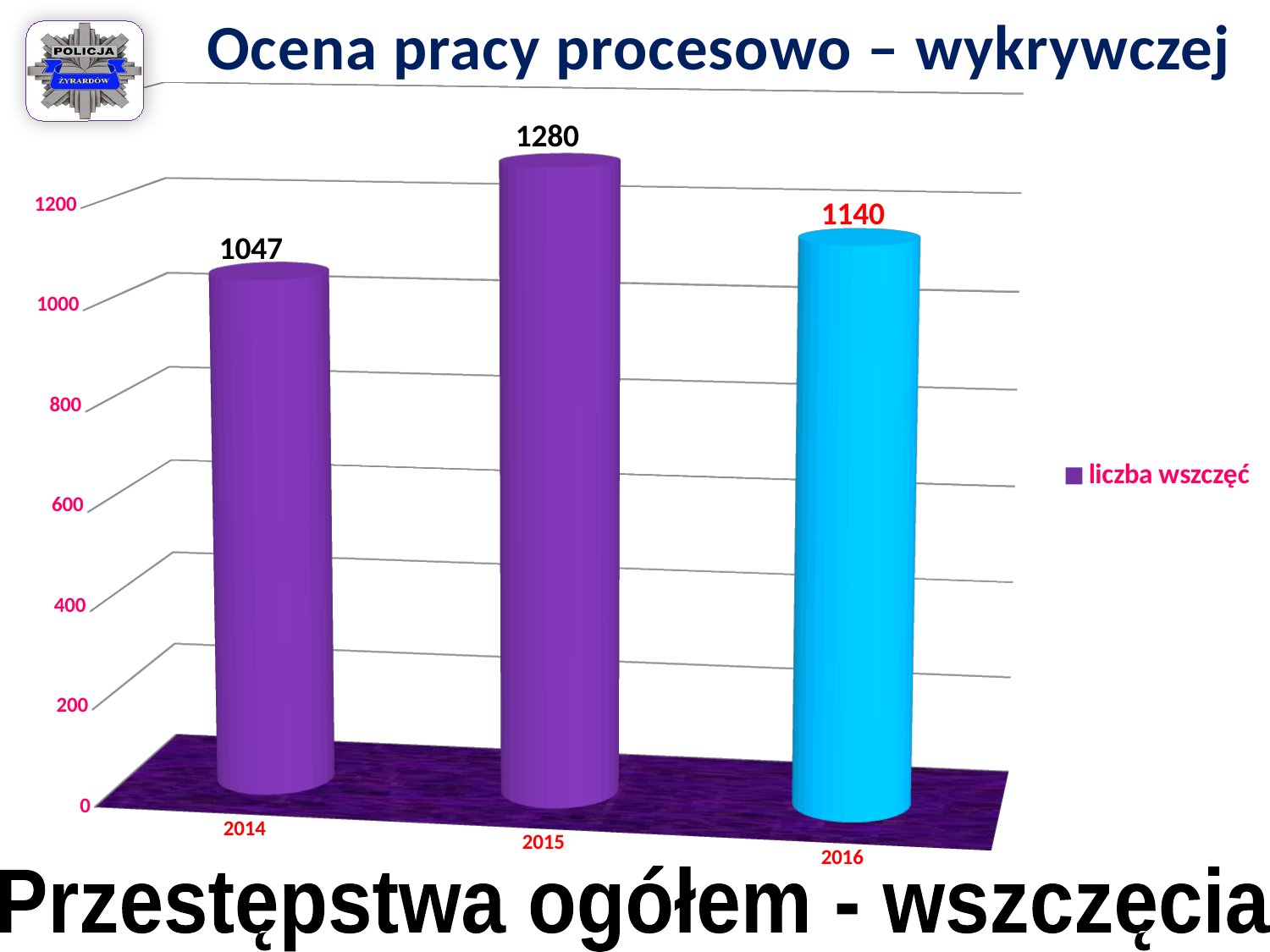
What is the value for 2015? 1280 What is the difference between the values for 2015 and 2014? 233 Is the value for 2014 greater or less than 1000? greater How many years are shown on the x axis? 3 Which year has the lowest value? 2014 What is the value for 2016? 1140 Which is larger, the value for 2016 or the value for 2014? 2016 Which year has the highest value? 2015 What kind of chart is shown on the slide? bar chart What is the difference between the values for 2015 and 2016? 140 What is the legend entry shown on the chart? liczba wszczęć What is the value for 2014? 1047